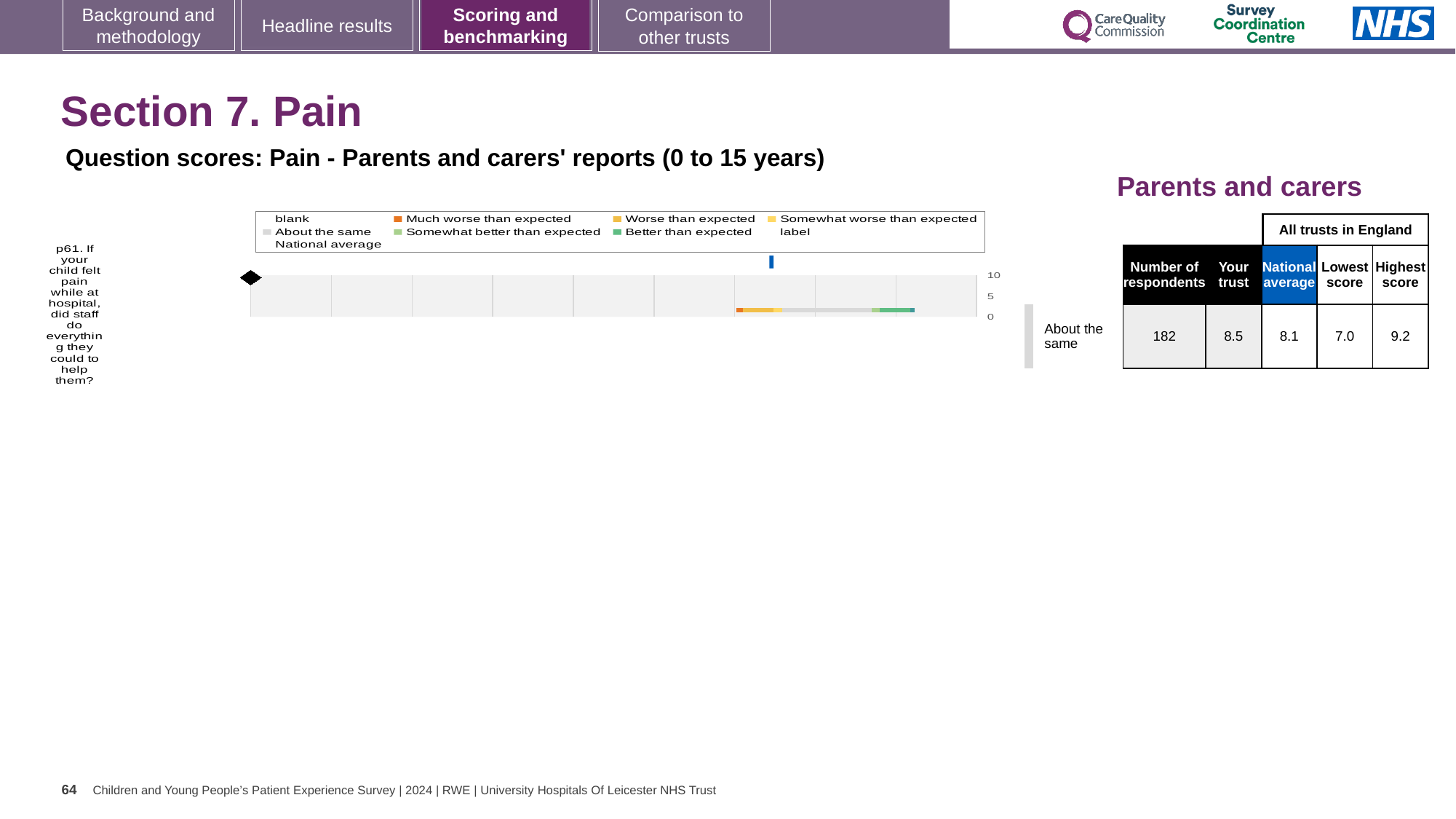
What is the difference between the highest score and the lowest score for p61? 2.2 What is the 'Your trust' score for p61? 8.5 How many survey questions are plotted in the chart? 1 Which legend entry is shown with an orange marker? Much worse than expected What is the lowest score among all trusts in England for p61? 7.0 What is the national average score for p61? 8.1 Which legend entry is shown with a dark green marker? Better than expected What kind of chart is used to show the p61 question score? bar chart What is the highest score among all trusts in England for p61? 9.2 Which benchmarking category is the trust's score for p61 placed in? About the same Is the 'Your trust' score for p61 higher or lower than the national average? higher How many respondents answered question p61? 182